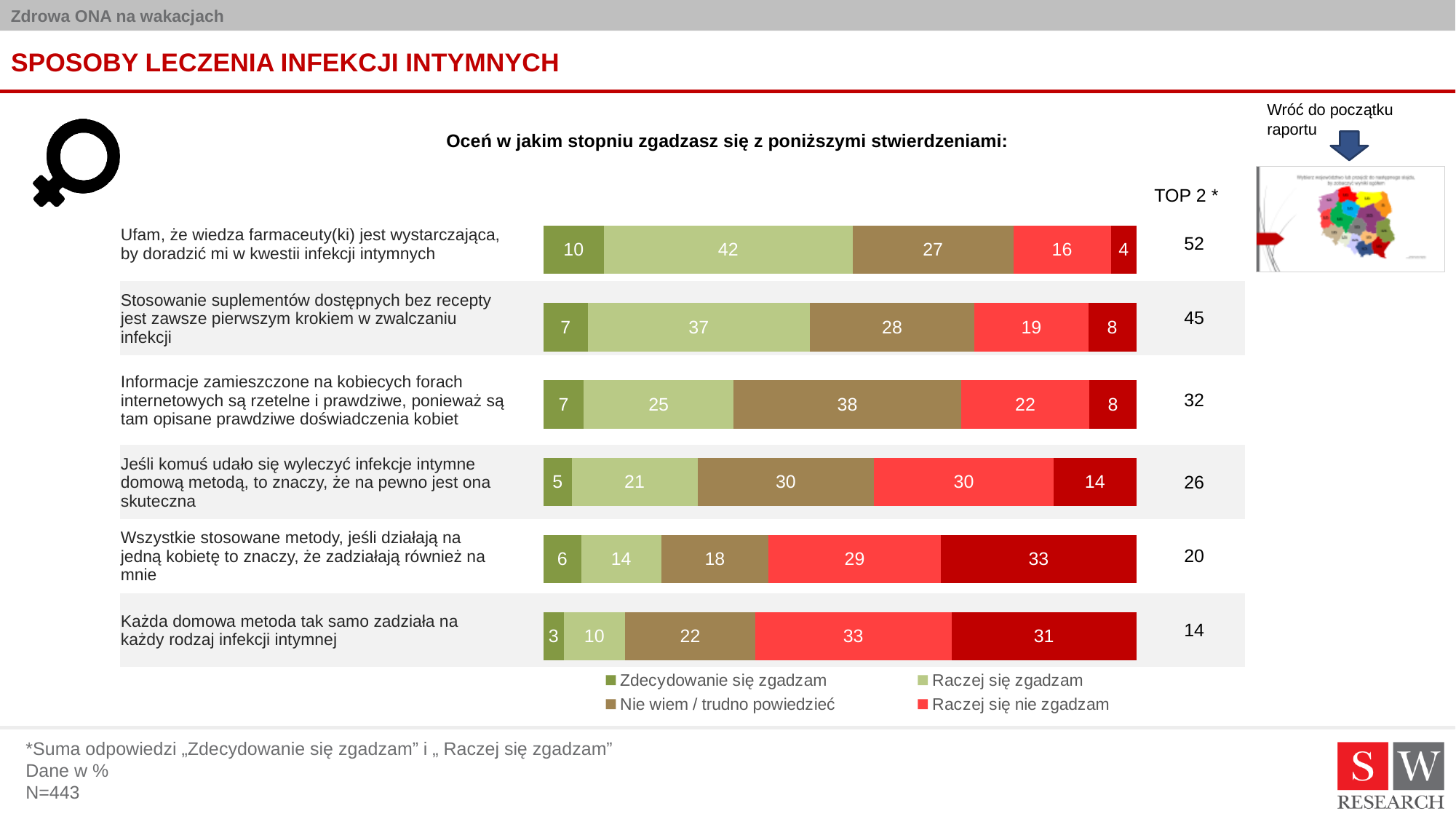
What is the 'Raczej się zgadzam' value for the statement 'Ufam, że wiedza farmaceuty(ki) jest wystarczająca, by doradzić mi w kwestii infekcji intymnych'? 42 What is the total of the 'Zdecydowanie się zgadzam' and 'Raczej się zgadzam' segments for the statement 'Jeśli komuś udało się wyleczyć infekcje intymne domową metodą...'? 26 What is the sample size (N) stated on the slide? N=443 What is the 'Nie wiem / trudno powiedzieć' value for the statement 'Informacje zamieszczone na kobiecych forach internetowych są rzetelne i prawdziwe...'? 38 What is the TOP 2 value for the statement 'Stosowanie suplementów dostępnych bez recepty jest zawsze pierwszym krokiem w zwalczaniu infekcji'? 45 How many statements (categories) are plotted in the chart? 6 What is the difference between the TOP 2 values of 'Ufam, że wiedza farmaceuty(ki) jest wystarczająca...' and 'Każda domowa metoda tak samo zadziała na każdy rodzaj infekcji intymnej'? 38 Which statement has the highest TOP 2 value? Ufam, że wiedza farmaceuty(ki) jest wystarczająca, by doradzić mi w kwestii infekcji intymnych Which is larger: the 'Raczej się nie zgadzam' value for 'Wszystkie stosowane metody, jeśli działają na jedną kobietę...' or for 'Każda domowa metoda tak samo zadziała...'? Każda domowa metoda tak samo zadziała na każdy rodzaj infekcji intymnej How many series does the chart legend list? 4 Which statement has the lowest TOP 2 value? Każda domowa metoda tak samo zadziała na każdy rodzaj infekcji intymnej What kind of chart is shown on the slide? stacked bar chart